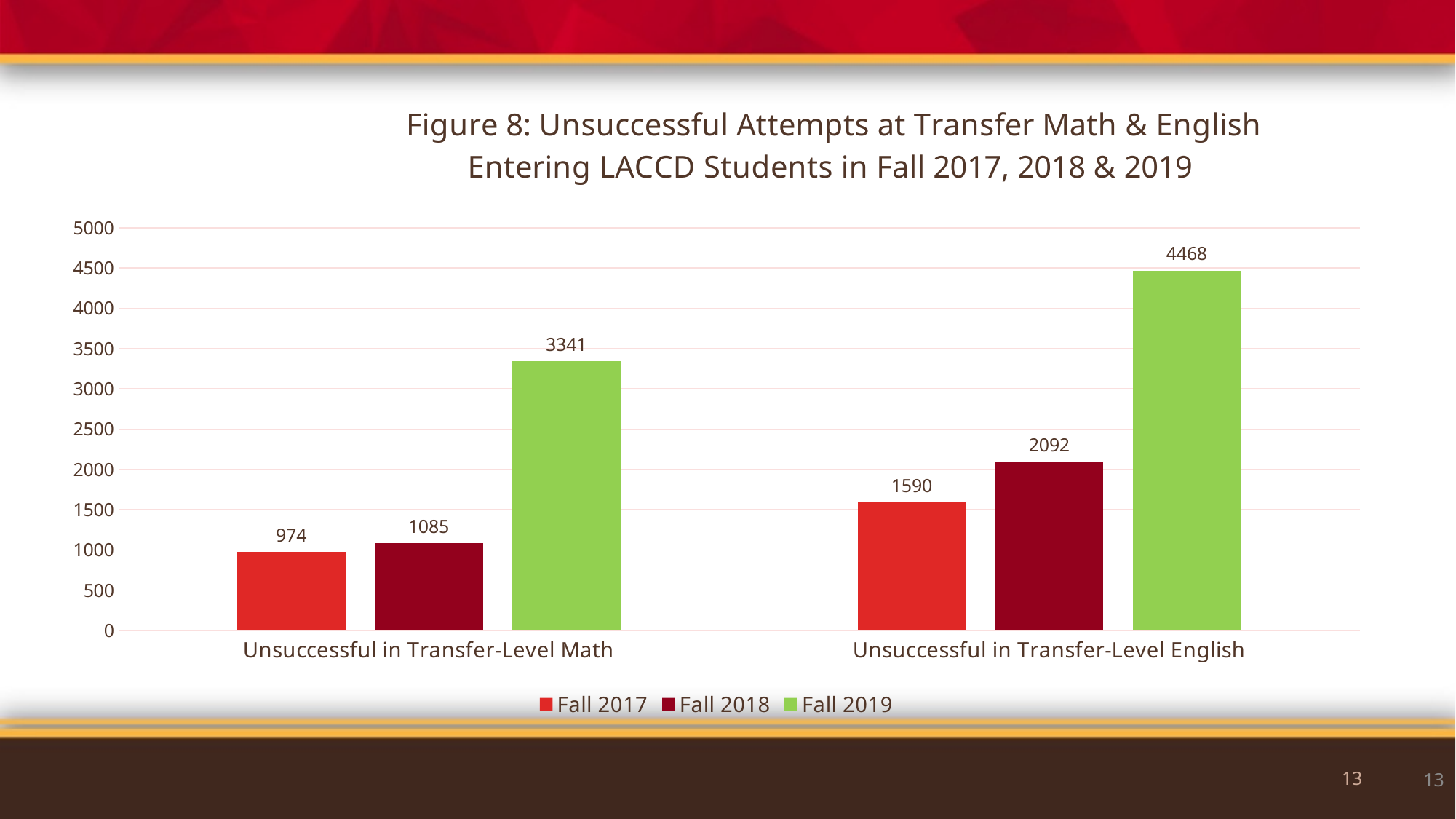
Which series has the highest value for Unsuccessful in Transfer-Level English? Fall 2019 What is the Fall 2019 value for Unsuccessful in Transfer-Level Math? 3341 What kind of chart is shown on the slide? bar chart Is the Fall 2019 value for Unsuccessful in Transfer-Level English greater or less than 4000? greater What is the Fall 2017 value for Unsuccessful in Transfer-Level English? 1590 What is the Fall 2018 value for Unsuccessful in Transfer-Level Math? 1085 What is the difference between the Fall 2019 and Fall 2018 values for Unsuccessful in Transfer-Level English? 2376 Which is larger: the Fall 2019 value for Unsuccessful in Transfer-Level Math or the Fall 2018 value for Unsuccessful in Transfer-Level English? Fall 2019 value for Unsuccessful in Transfer-Level Math Which series has the lowest value for Unsuccessful in Transfer-Level Math? Fall 2017 How many series does the legend list? 3 What is the difference between the Fall 2018 and Fall 2017 values for Unsuccessful in Transfer-Level Math? 111 Which colour represents Fall 2019 in the chart? green